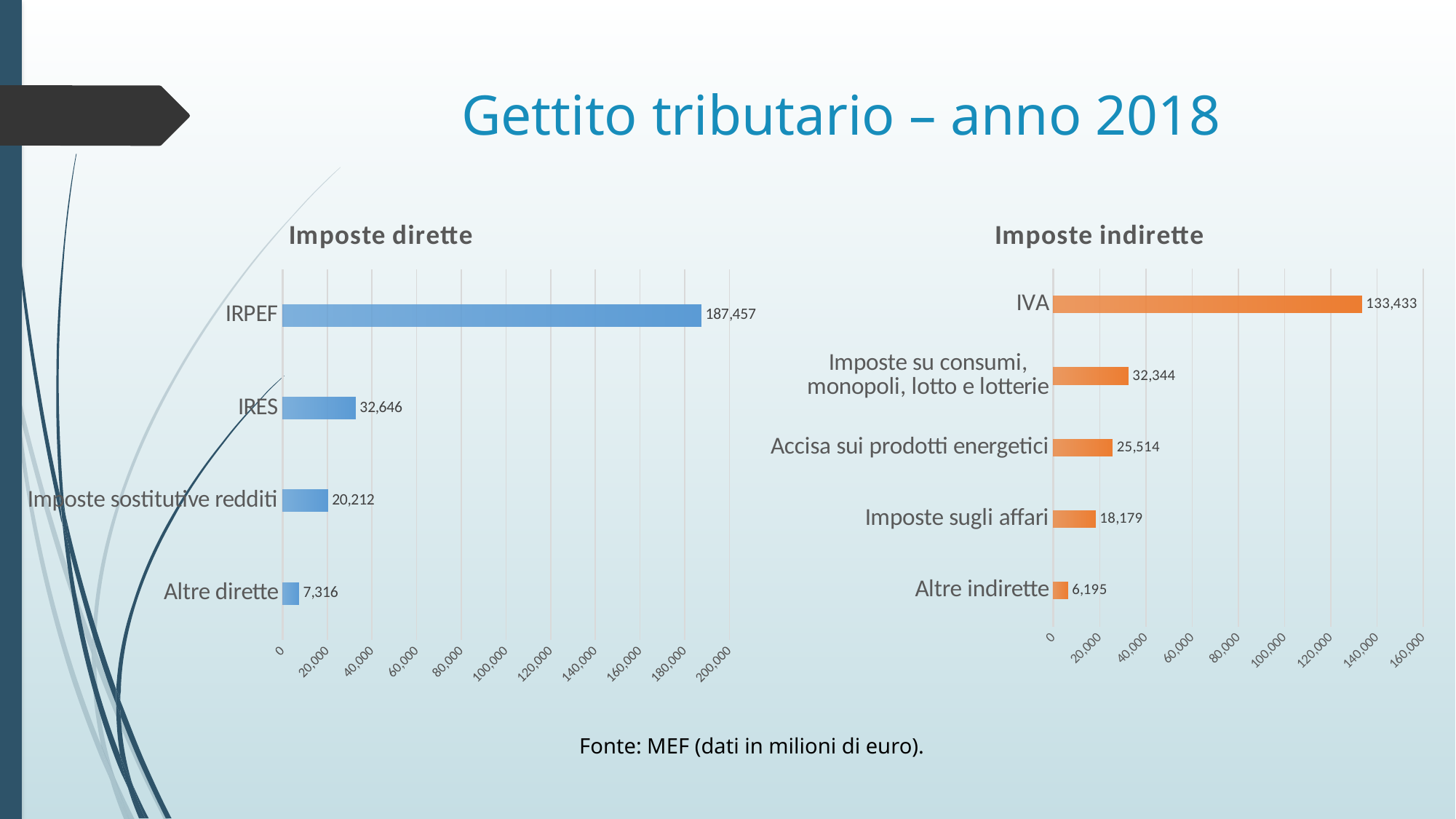
In the 'Imposte indirette' chart, what is the value for IVA? 133,433 In the 'Imposte indirette' chart, which category has the highest value? IVA In the 'Imposte dirette' chart, what is the value for IRPEF? 187,457 How many categories are shown in the 'Imposte dirette' chart? 4 How many categories are shown in the 'Imposte indirette' chart? 5 Which is larger: IRES in the 'Imposte dirette' chart or Imposte su consumi, monopoli, lotto e lotterie in the 'Imposte indirette' chart? IRES In the 'Imposte indirette' chart, what is the value for Accisa sui prodotti energetici? 25,514 In the 'Imposte dirette' chart, which category has the lowest value? Altre dirette In the 'Imposte indirette' chart, what is the difference between Imposte sugli affari and Altre indirette? 11,984 In the 'Imposte dirette' chart, what is the difference between IRPEF and IRES? 154,811 What kind of chart is the 'Imposte dirette' chart? Bar chart In the 'Imposte dirette' chart, what is the value for IRES? 32,646